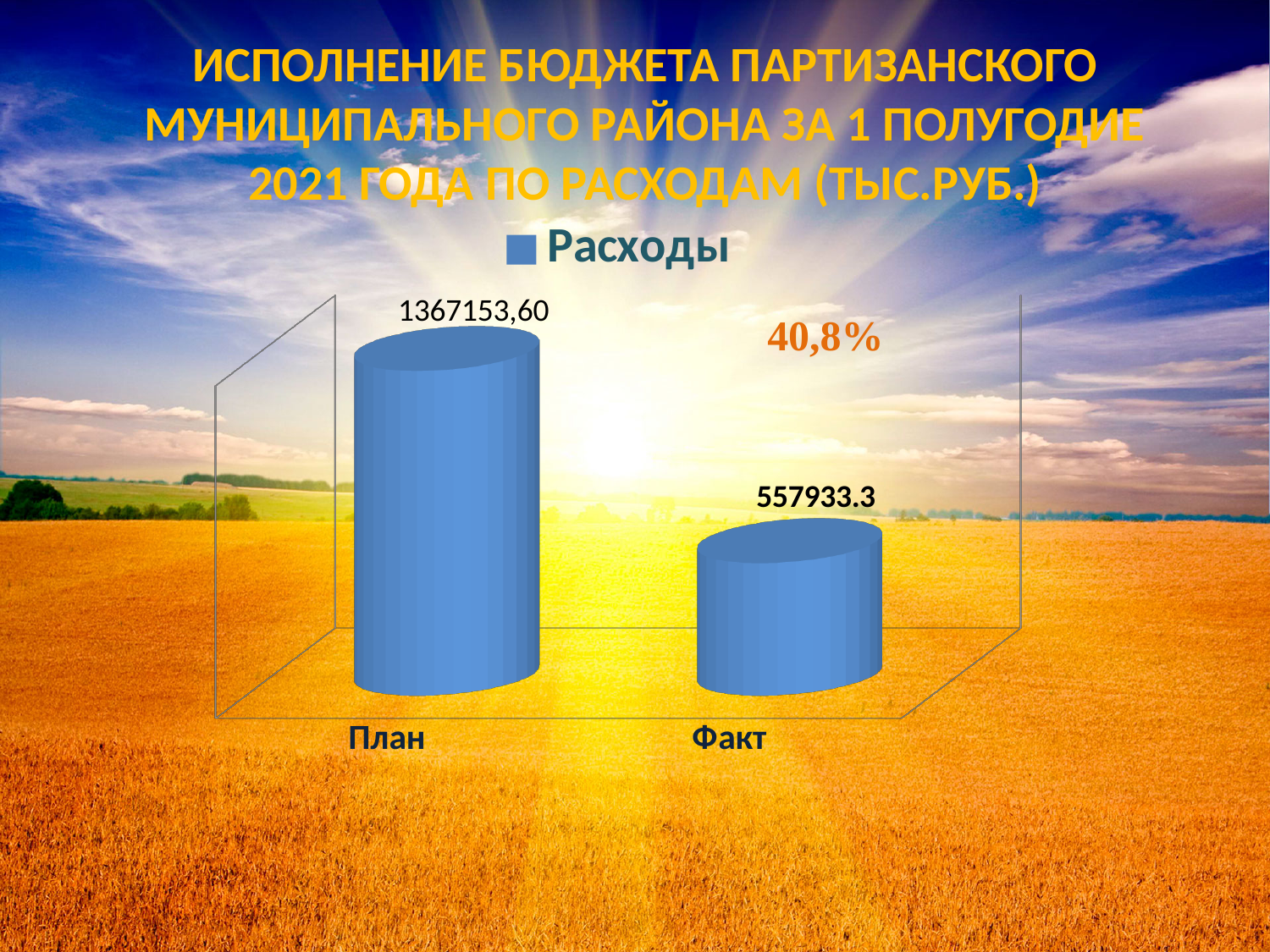
What is the name of the series in the legend? Расходы What is the value for Факт? 557933.3 What percentage is printed above the Факт bar? 40,8% How many categories are shown on the x axis? 2 What is the value for План? 1367153,60 How many series does the legend list? 1 What kind of chart is shown on the slide? bar chart Which category has the highest value? План Do the values rise or fall from План to Факт? fall Which is larger, the value for План or the value for Факт? План Which category has the lowest value? Факт What is the difference between the value for План and the value for Факт? 809220,30